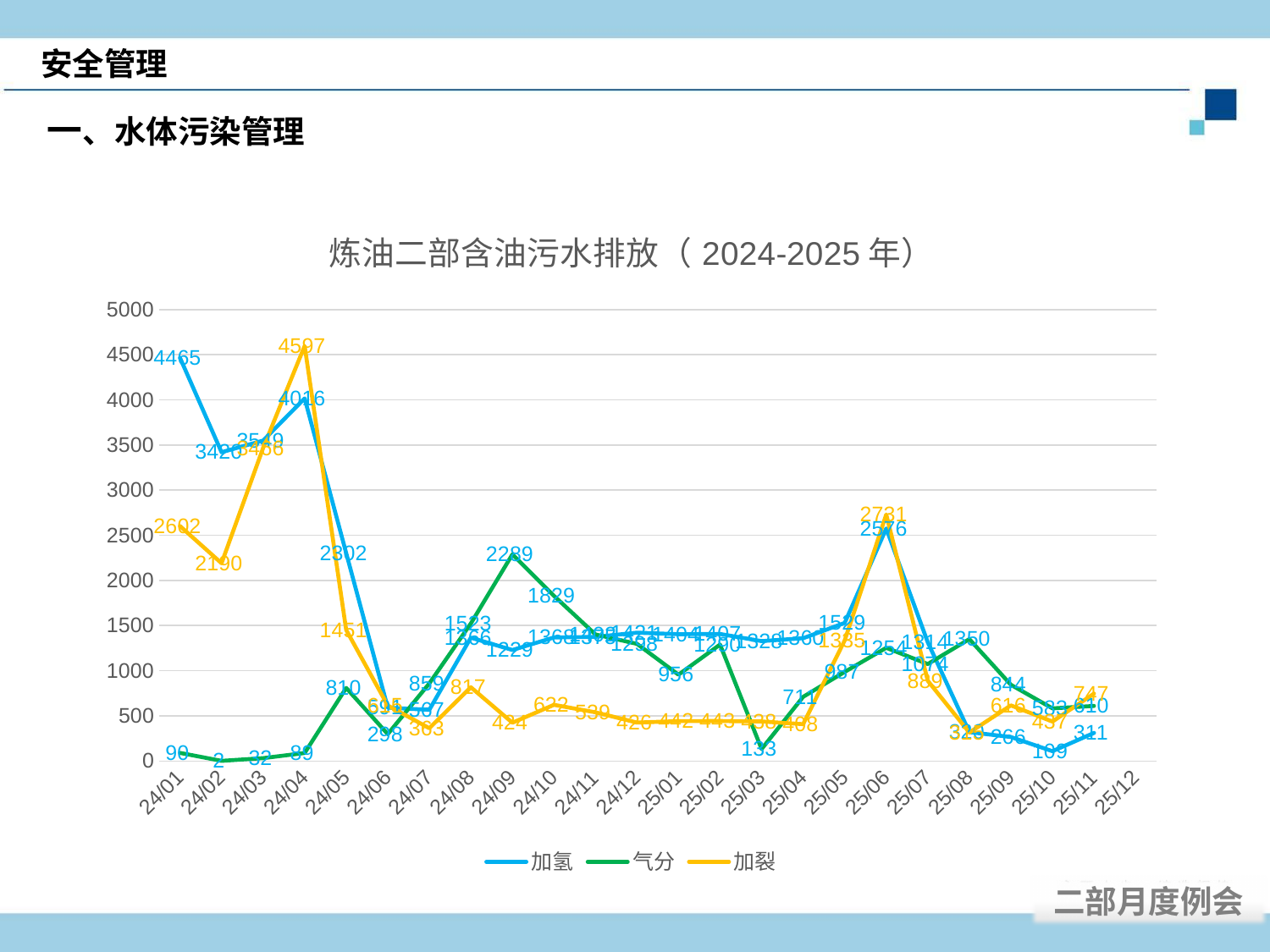
What is the value of 气分 in 24/09? 2289 Does the 加氢 line rise or fall from 25/06 to 25/10? fall In which month does 加氢 reach its highest value? 24/01 How many series does the legend list? 3 What is the value of 加裂 in 24/04? 4597 What is the value of 加氢 in 24/01? 4465 In which month does 加裂 reach its highest value? 24/04 What kind of chart is shown on the slide? line chart What is the value of 气分 in 25/03? 133 Which is larger in 24/01, 加氢 or 加裂? 加氢 What is the difference between 加裂 and 加氢 in 25/06? 155 Is the value for 加氢 in 24/05 greater or less than 2000? greater